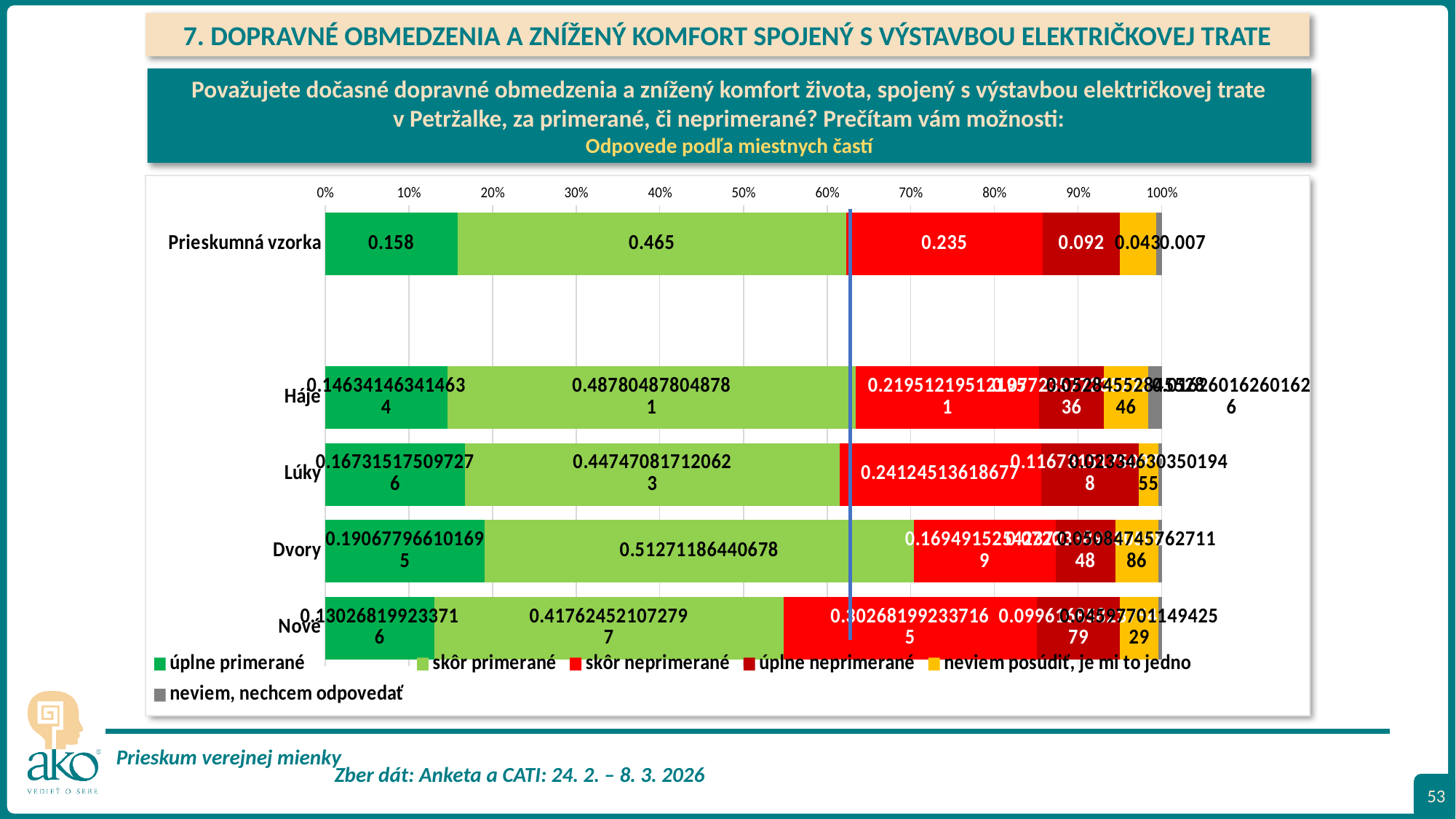
In the 'Prieskumná vzorka' row, what is the difference between 'skôr primerané' and 'úplne primerané'? 0.307 What is the value for 'úplne primerané' in the 'Prieskumná vzorka' row? 0.158 How many categories (rows) are plotted in the chart? 5 Which series has the highest value in the 'Prieskumná vzorka' row? skôr primerané How many series does the chart legend list? 6 What is the value for 'skôr primerané' in the 'Prieskumná vzorka' row? 0.465 In the 'Prieskumná vzorka' row, which is larger: 'skôr primerané' or 'skôr neprimerané'? skôr primerané Is the value for 'úplne primerané' in the 'Dvory' row greater or less than 10%? greater Which colour represents 'úplne primerané' in the legend? green What is the value for 'úplne neprimerané' in the 'Prieskumná vzorka' row? 0.092 What is the value for 'skôr neprimerané' in the 'Prieskumná vzorka' row? 0.235 What kind of chart is shown on the slide? bar chart